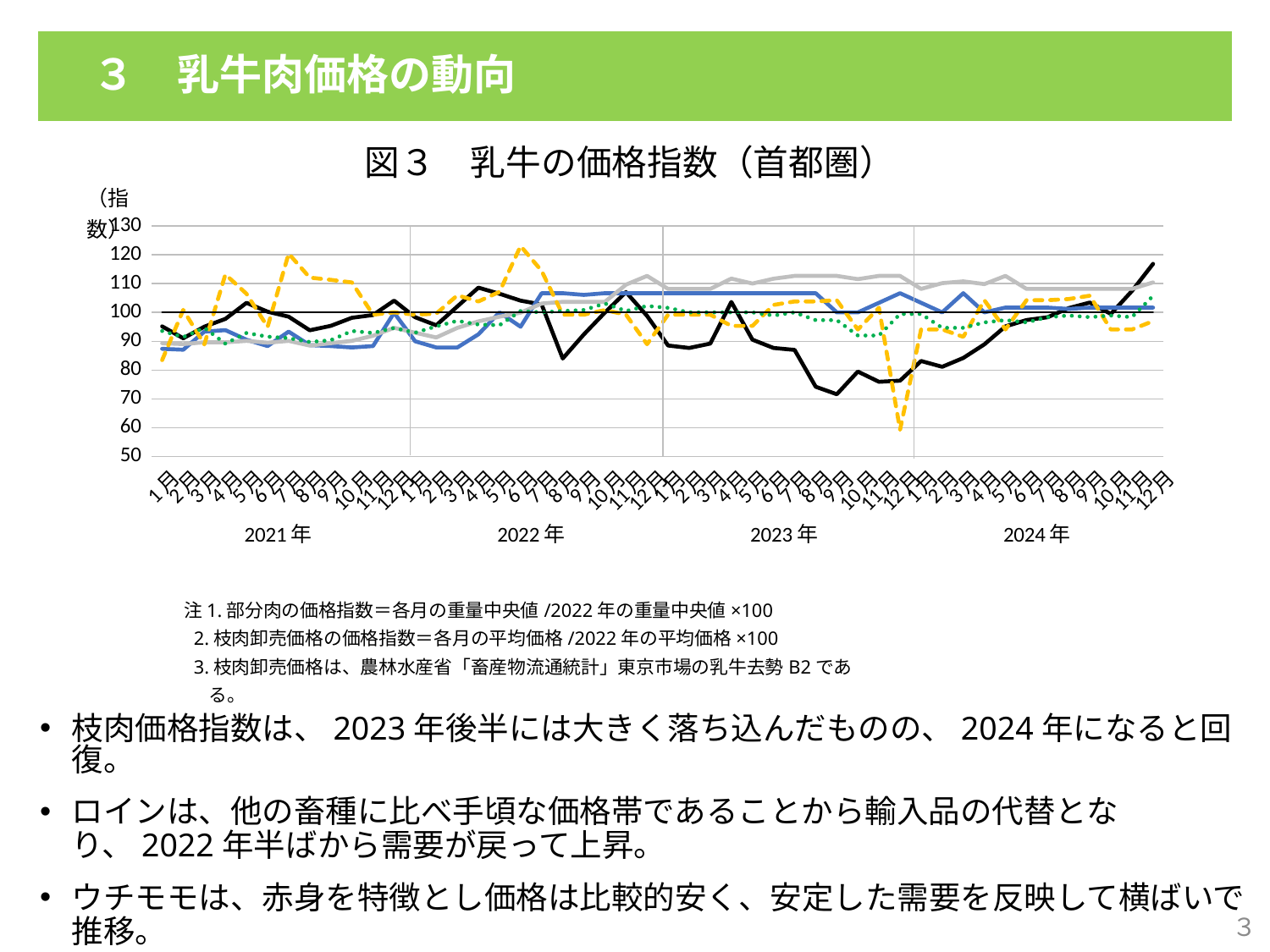
Is the value of the blue solid line in 2021年1月 greater or less than 90? less Is the value of the yellow dashed line in 2022年6月 greater or less than 110? greater Does the black solid line rise or fall from 2024年1月 to 2024年12月? rise What is the highest value shown on the y axis of the chart? 130 How many lines are plotted in the chart? 6 What kind of chart is shown in 図３ 乳牛の価格指数（首都圏）? line chart What is the title of the chart on the slide? 図３ 乳牛の価格指数（首都圏） In 2023年12月, which line is lower: the yellow dashed line or the gray solid line? yellow dashed line Is the value of the black solid line in 2024年12月 greater or less than 110? greater How many years are labelled along the x axis of the chart? 4